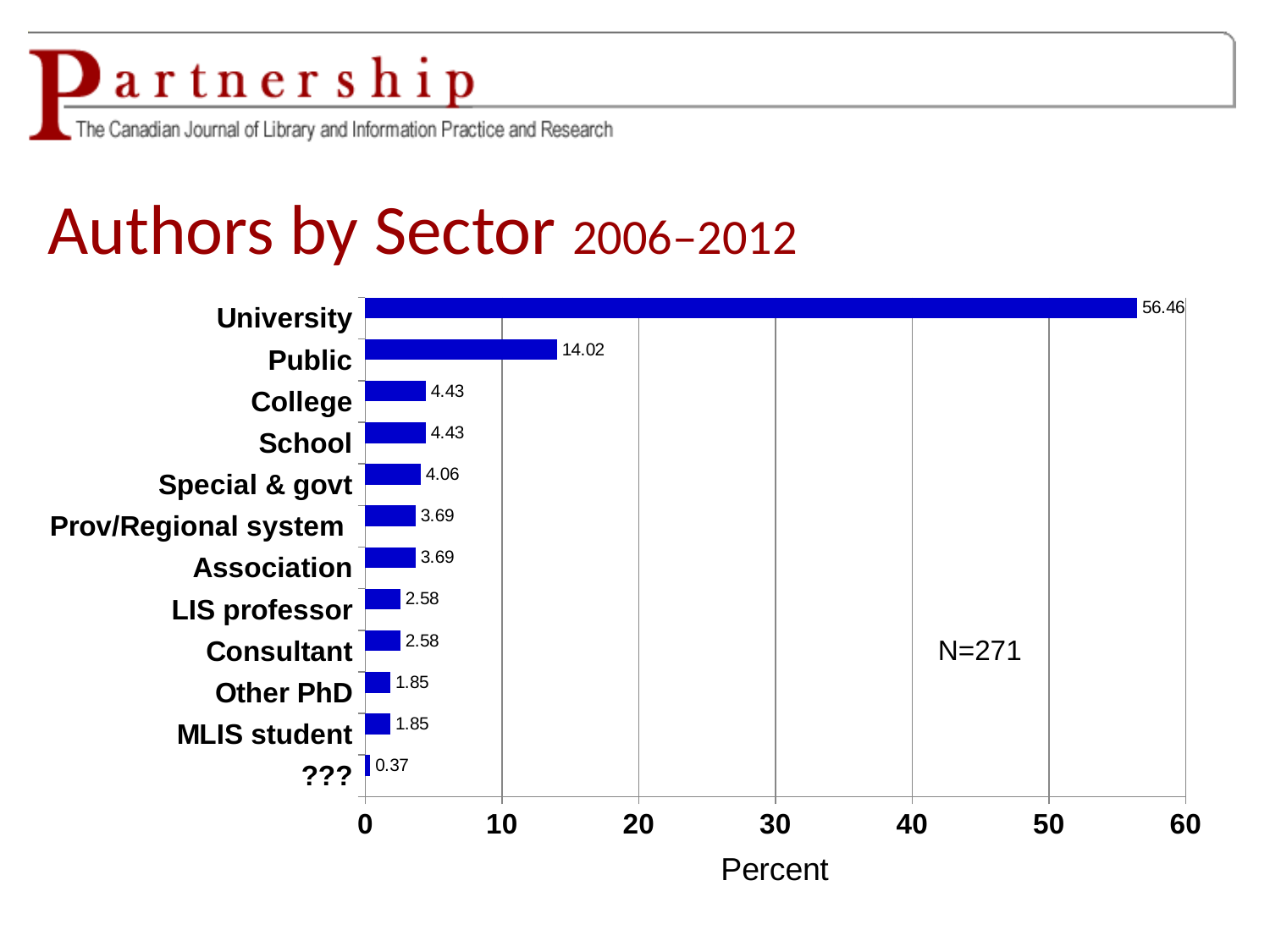
What is the difference between the values for University and Public? 42.44 What is the value for MLIS student? 1.85 What is the value for Public? 14.02 What is the value for University? 56.46 How many sectors are shown in the chart? 12 What is the label of the x axis? Percent Which sector has the highest value? University What kind of chart is shown on the slide? bar chart What is the value for Special & govt? 4.06 Which is larger, the value for Public or the value for College? Public Which sector has the lowest value? ??? Is the value for University greater or less than 50? greater